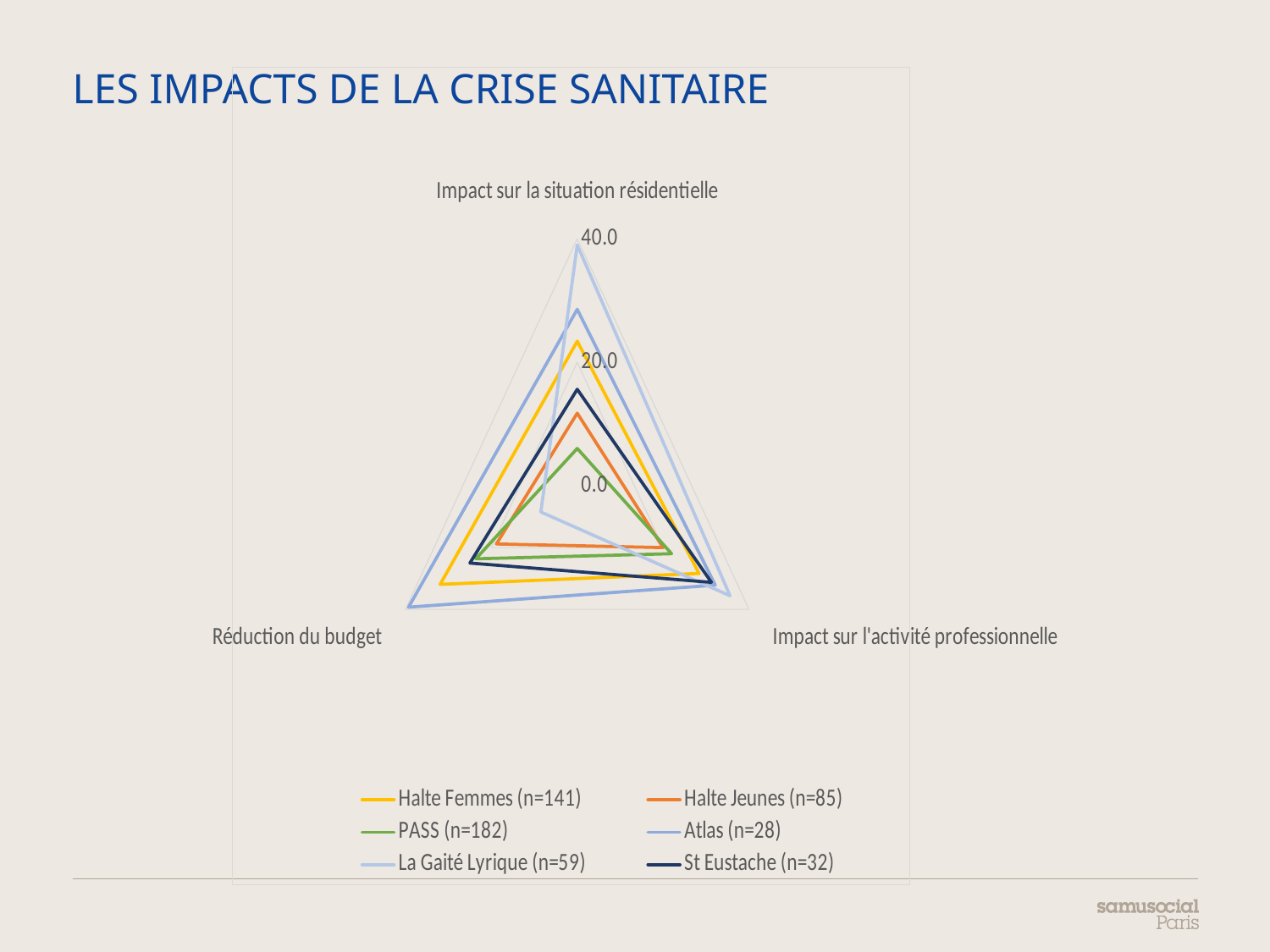
Is the value for PASS (n=182) on 'Impact sur la situation résidentielle' greater or less than 20.0? less Is the value for Atlas (n=28) on 'Impact sur la situation résidentielle' greater or less than 20.0? greater Which series has the lowest value for 'Impact sur la situation résidentielle'? PASS (n=182) How many categories (axes) does the radar chart have? 3 Which series has the highest value for 'Réduction du budget'? Atlas (n=28) Which series in the legend has n=182? PASS (n=182) What is the title of the slide containing the chart? LES IMPACTS DE LA CRISE SANITAIRE Is the value for Halte Jeunes (n=85) on 'Impact sur la situation résidentielle' greater or less than 20.0? less How many series does the legend list? 6 What kind of chart is shown on the slide? Radar chart Which series has the highest value for 'Impact sur la situation résidentielle'? La Gaité Lyrique (n=59) For 'Impact sur la situation résidentielle', which is larger: the value for Atlas (n=28) or for PASS (n=182)? Atlas (n=28)